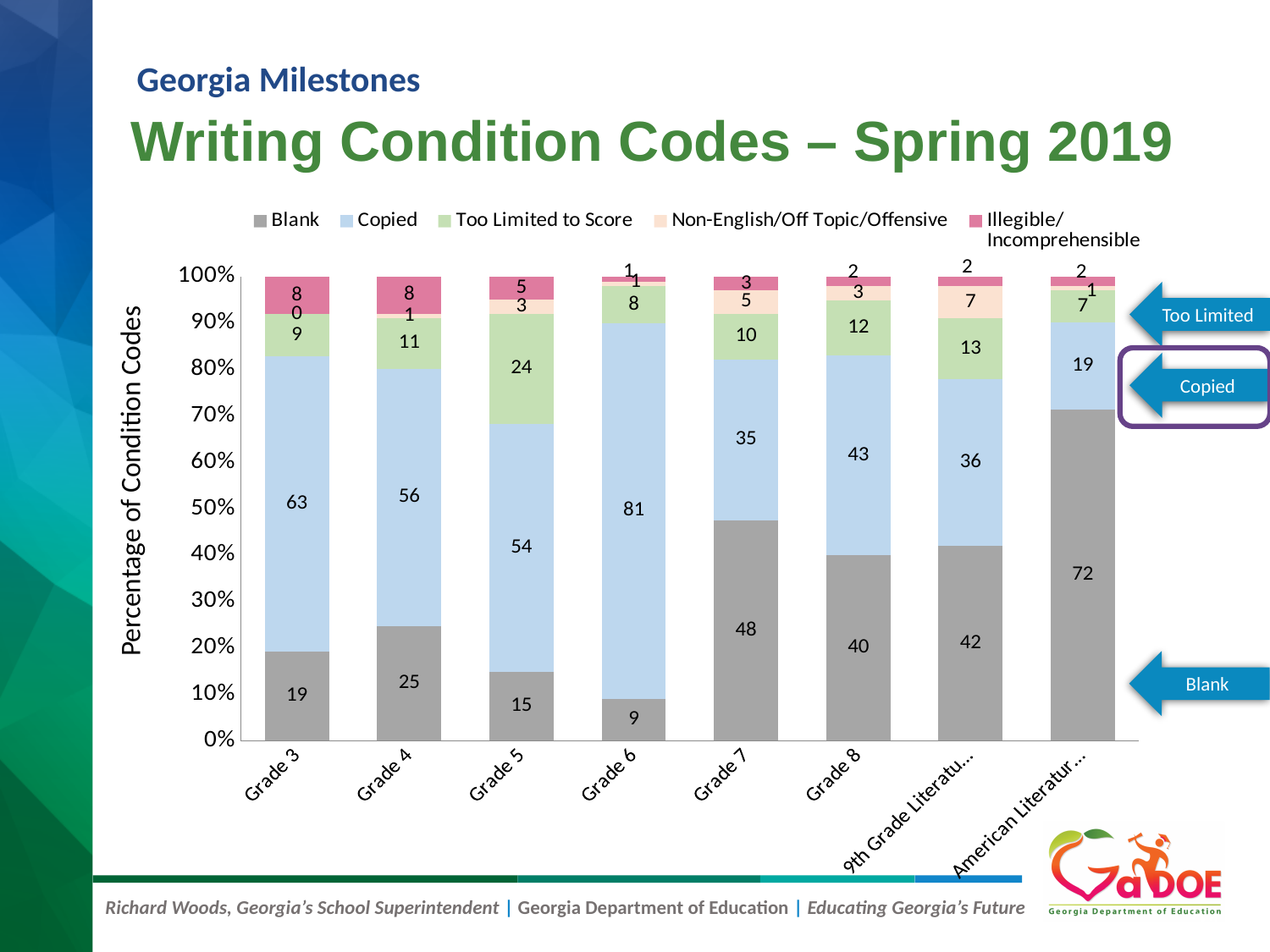
What is the Too Limited to Score value for Grade 5? 24 What type of chart is shown on the slide? Stacked bar chart Which category has the highest Blank value? American Literature (rightmost bar) What is the difference between the Copied values for Grade 3 and Grade 4? 7 What is the Blank value for Grade 7? 48 How many grade/course categories are shown on the x axis? 8 What is the Illegible/Incomprehensible value for Grade 3? 8 Which grade has the lowest Blank value? Grade 6 Which is larger for Grade 8, the Blank value or the Copied value? Copied How many series does the legend list? 5 What is the label on the y axis? Percentage of Condition Codes What is the Copied value for Grade 6? 81